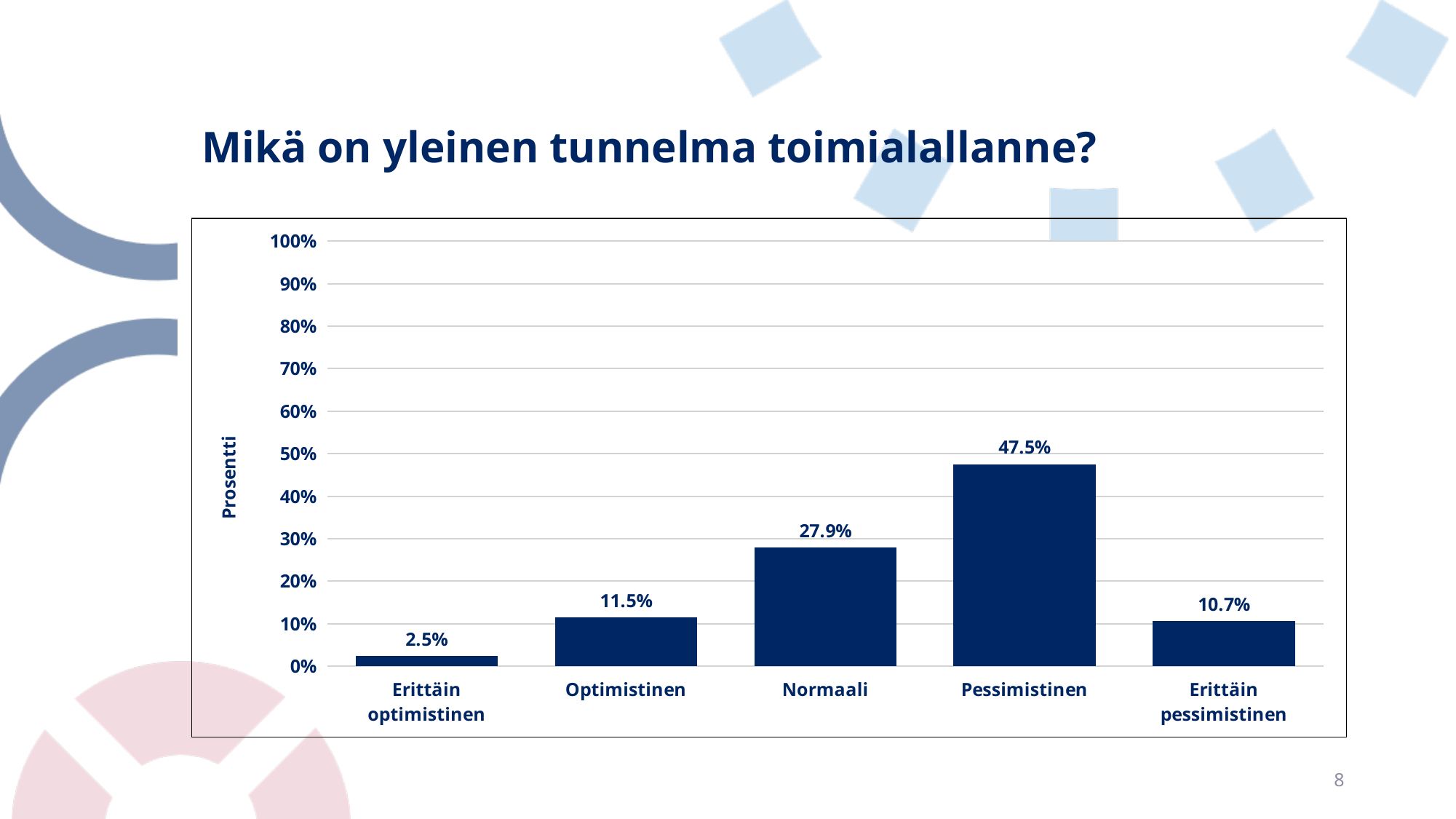
Which category has the highest value? Pessimistinen What is the value for Pessimistinen? 47.5% Which is larger, the value for Optimistinen or the value for Erittäin pessimistinen? Optimistinen What is the difference between the values for Optimistinen and Erittäin pessimistinen? 0.8% What is the value for Normaali? 27.9% What is the label of the vertical axis? Prosentti Which category has the lowest value? Erittäin optimistinen What is the value for Erittäin optimistinen? 2.5% How many categories are shown on the x axis? 5 What kind of chart is shown on the slide? bar chart Is the value for Normaali greater or less than 30%? less What is the difference between the values for Pessimistinen and Normaali? 19.6%